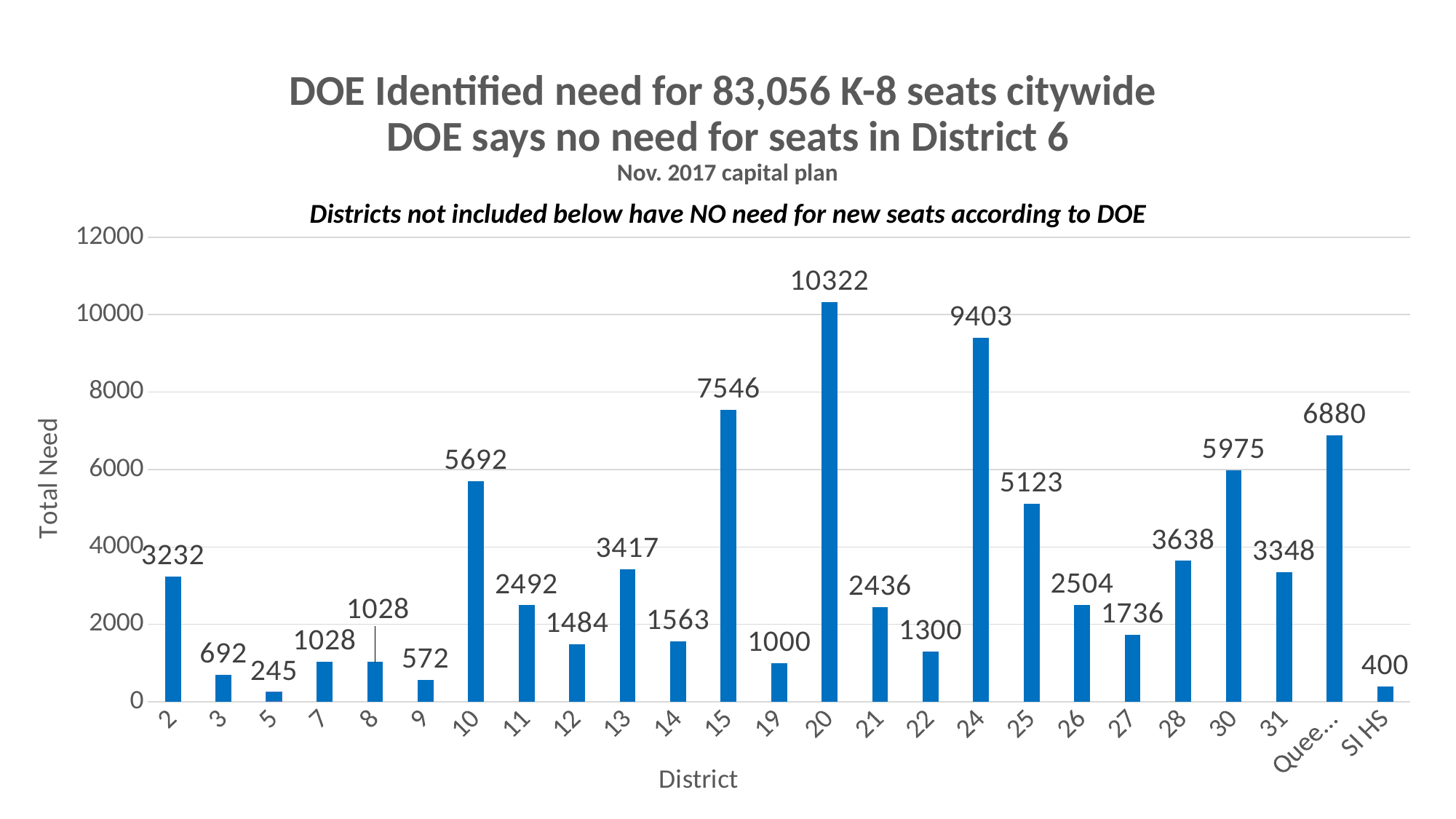
Is the Total Need for District 28 greater or less than 4000? less What type of chart is shown on the slide? bar chart Which district has the lowest Total Need? 5 What is the Total Need value for District 15? 7546 Which has a larger Total Need, District 30 or District 25? District 30 What is the difference in Total Need between District 15 and District 10? 1854 What is the difference in Total Need between District 20 and District 24? 919 Which district has the highest Total Need? 20 What is the Total Need value for SI HS? 400 What is the label of the y axis? Total Need How many districts/categories are shown on the x axis? 25 What is the Total Need value for District 20? 10322